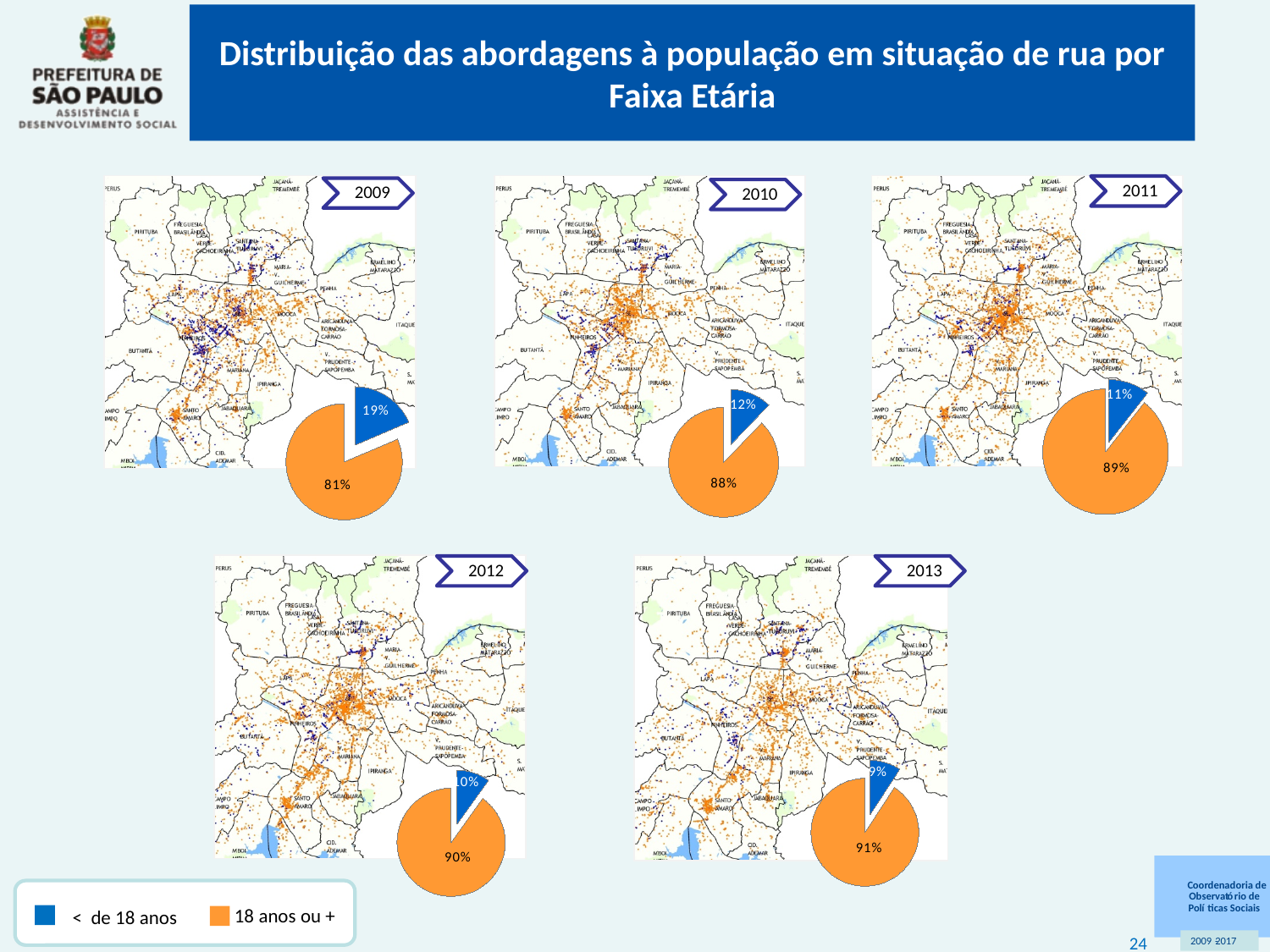
In the 2011 pie chart, what share of approaches was for people aged 18 or older? 89% In the 2013 pie chart, what share of approaches was for people aged 18 or older? 91% In the 2009 pie chart, what share of approaches was for people under 18 years old (< de 18 anos)? 19% In the 2012 pie chart, what share of approaches was for people under 18 years old? 10% How many categories does the legend at the bottom of the slide list for the pie charts? 2 Across the five pie charts, which year has the largest share for people under 18 years old? 2009 In the 2010 pie chart, what share of approaches was for people under 18 years old? 12% Looking at the pie charts from 2009 to 2013, does the share for people under 18 years old rise or fall over the years? fall In the 2009 pie chart, what share of approaches was for people aged 18 or older (18 anos ou +)? 81% Across the five pie charts, which year has the smallest share for people under 18 years old? 2013 Which is larger: the under-18 share in the 2010 pie chart or the under-18 share in the 2011 pie chart? 2010 What is the difference in percentage points between the under-18 share in the 2009 pie chart and the under-18 share in the 2013 pie chart? 10 percentage points